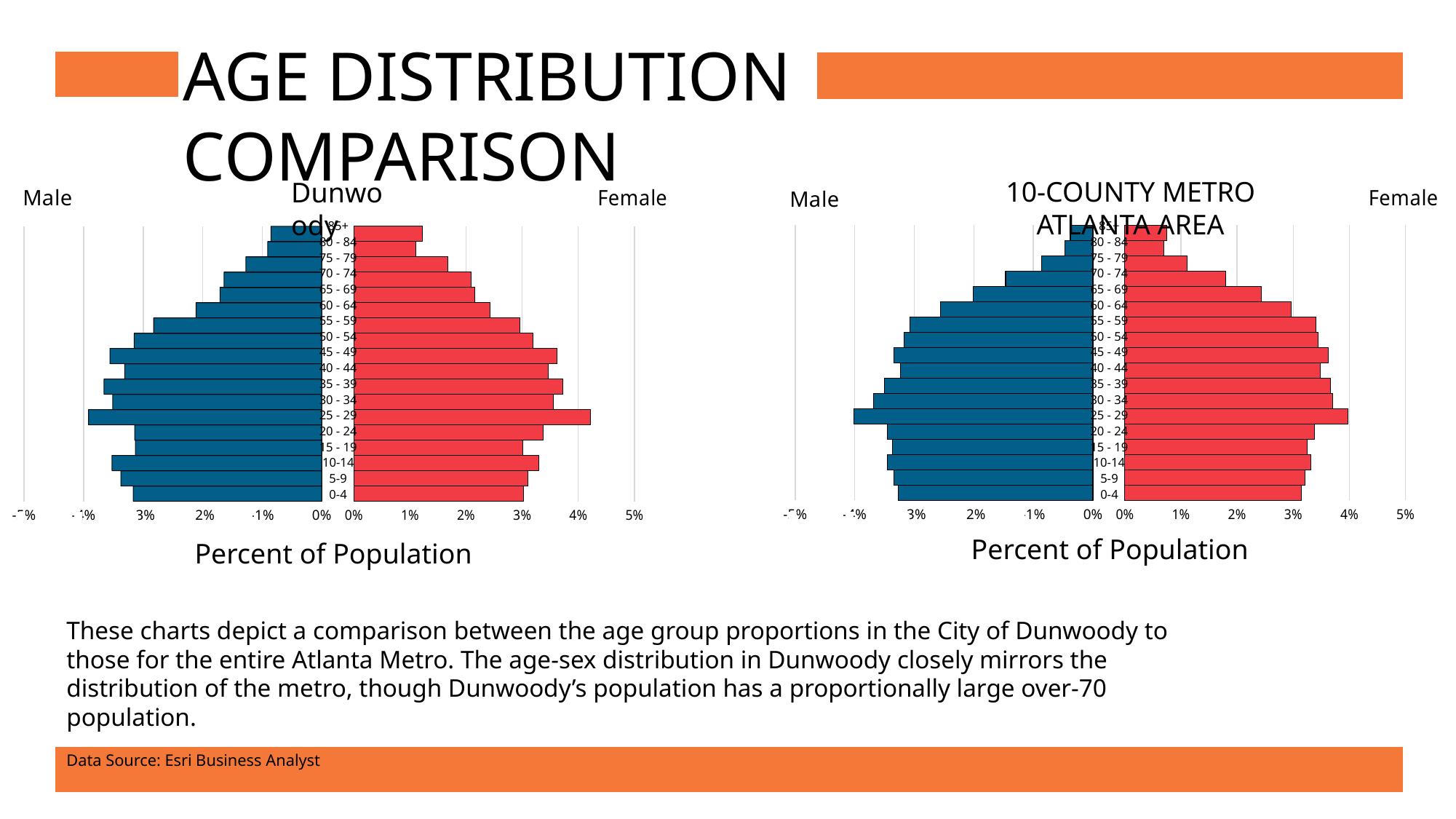
How many age groups are shown on the Dunwoody chart? 18 On the 10-County Metro Atlanta Area chart, is the Female value for 45 - 49 greater or less than 3%? greater What kind of chart is the Dunwoody chart on the left? bar chart What is the x-axis title of the 10-County Metro Atlanta Area chart? Percent of Population On the Dunwoody chart, which age group has the shortest Male bar? 85+ On the 10-County Metro Atlanta Area chart, which age group has the longest Male bar? 25 - 29 On the Dunwoody chart, which is larger, the Male value for 25 - 29 or the Male value for 70 - 74? 25 - 29 On the 10-County Metro Atlanta Area chart, is the Male value for 70 - 74 greater or less than 2%? less On the Dunwoody chart, which age group has the longest Female bar? 25 - 29 On the Dunwoody chart, is the Female value for 35 - 39 greater or less than 3%? greater On the 10-County Metro Atlanta Area chart, which age group has the shortest Female bar? 80 - 84